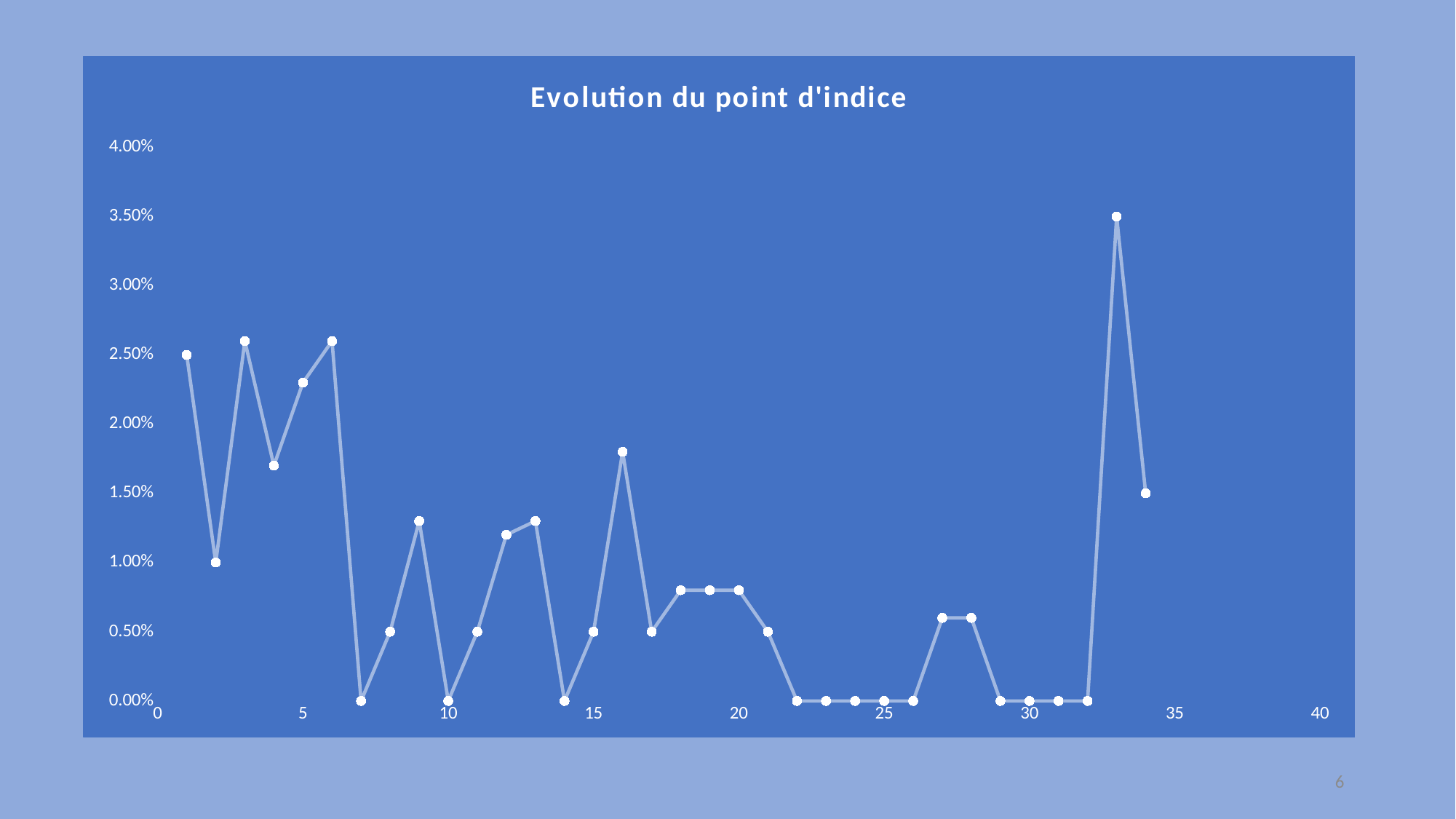
What is the value at x = 33? 3.50% What kind of chart is shown on the slide? line chart At which x value does the line reach its highest point? 33 What is the lowest value reached on the chart? 0.00% What is the value at x = 2? 1.00% Which is larger, the value at x = 3 or the value at x = 4? x = 3 How many data points are plotted on the chart? 34 What is the value at x = 34? 1.50% What is the value at x = 1? 2.50% What is the difference between the values at x = 33 and x = 34? 2.00% What is the title of the chart? Evolution du point d'indice Is the value at x = 16 greater or less than 1.50%? greater